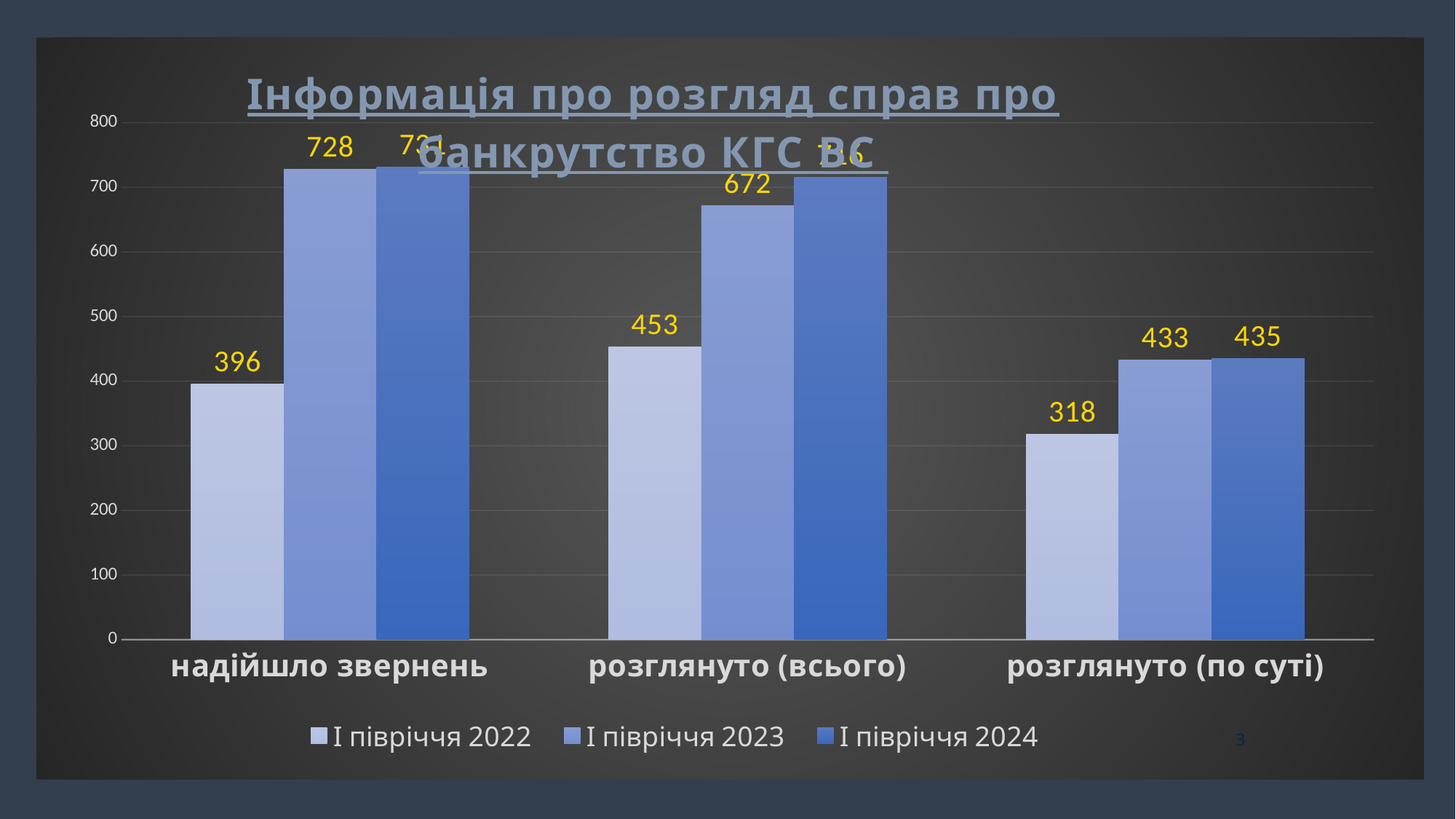
How many series does the legend list? 3 What kind of chart is shown on the slide? bar chart What is the difference between the I півріччя 2023 and I півріччя 2022 values for розглянуто (всього)? 219 Is the I півріччя 2024 value for надійшло звернень greater or less than 600? greater What is the value for I півріччя 2023 in the category розглянуто (всього)? 672 Which is larger for I півріччя 2022: надійшло звернень or розглянуто (всього)? розглянуто (всього) How many categories are shown on the x axis? 3 What is the value for I півріччя 2022 in the category розглянуто (по суті)? 318 What is the difference between the I півріччя 2023 and I півріччя 2022 values for надійшло звернень? 332 In which category is the I півріччя 2023 value lowest? розглянуто (по суті) What is the value for I півріччя 2022 in the category надійшло звернень? 396 What is the value for I півріччя 2024 in the category розглянуто (по суті)? 435